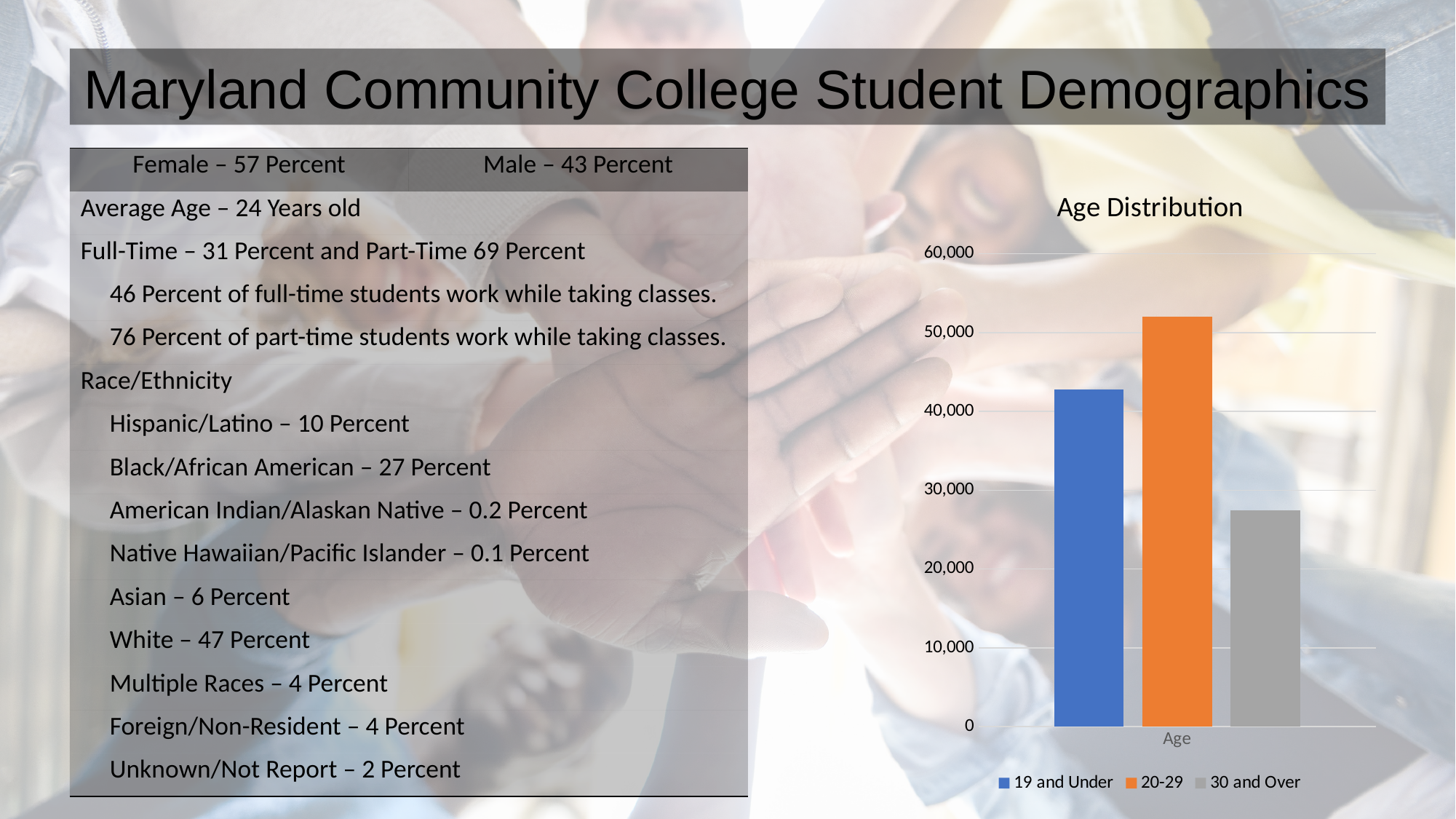
Is the value for 20-29 in the Age Distribution chart greater or less than 50,000? greater What kind of chart is the Age Distribution chart? bar chart Is the value for 19 and Under in the Age Distribution chart greater or less than 50,000? less How many series does the legend of the Age Distribution chart list? 3 Which age group has the lowest value in the Age Distribution chart? 30 and Over Is the value for 30 and Over in the Age Distribution chart greater or less than 30,000? less What colour is the bar for the 20-29 series in the Age Distribution chart? orange In the Age Distribution chart, which is larger: 20-29 or 19 and Under? 20-29 What is the title of the chart on the slide? Age Distribution In the Age Distribution chart, which is larger: 19 and Under or 30 and Over? 19 and Under Which age group has the highest value in the Age Distribution chart? 20-29